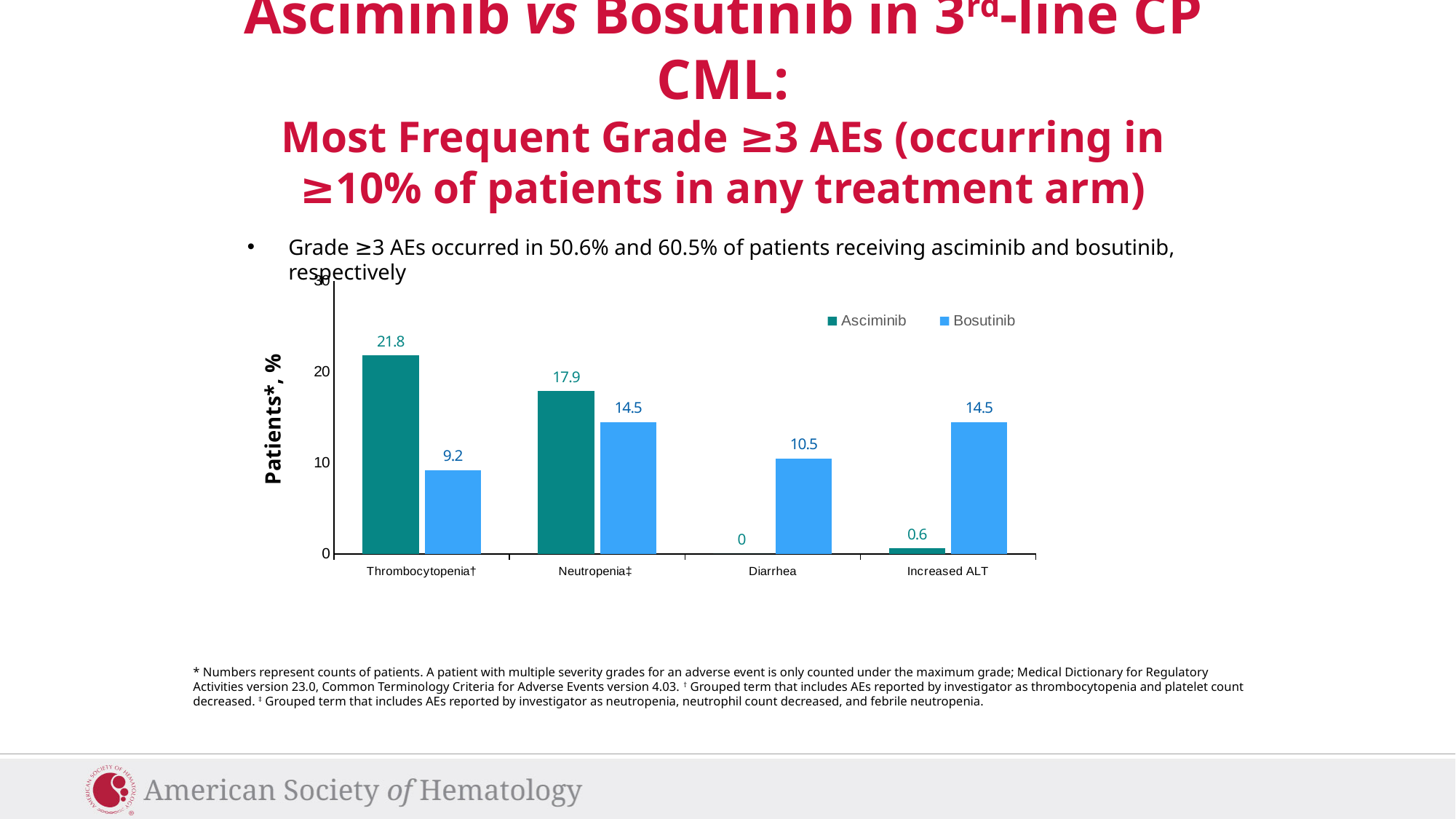
What is the Asciminib value for Increased ALT? 0.6 What is the difference between the Asciminib and Bosutinib values for Thrombocytopenia†? 12.6 How many series does the legend list? 2 What kind of chart is shown on the slide? Bar chart Which category has the highest Asciminib value? Thrombocytopenia† What is the Asciminib value for Thrombocytopenia†? 21.8 What is the Bosutinib value for Neutropenia‡? 14.5 For Neutropenia‡, which series has the larger value, Asciminib or Bosutinib? Asciminib What is the Bosutinib value for Diarrhea? 10.5 How many categories are shown on the x axis? 4 What is the label of the y axis? Patients*, % Which category has the lowest Bosutinib value? Thrombocytopenia†